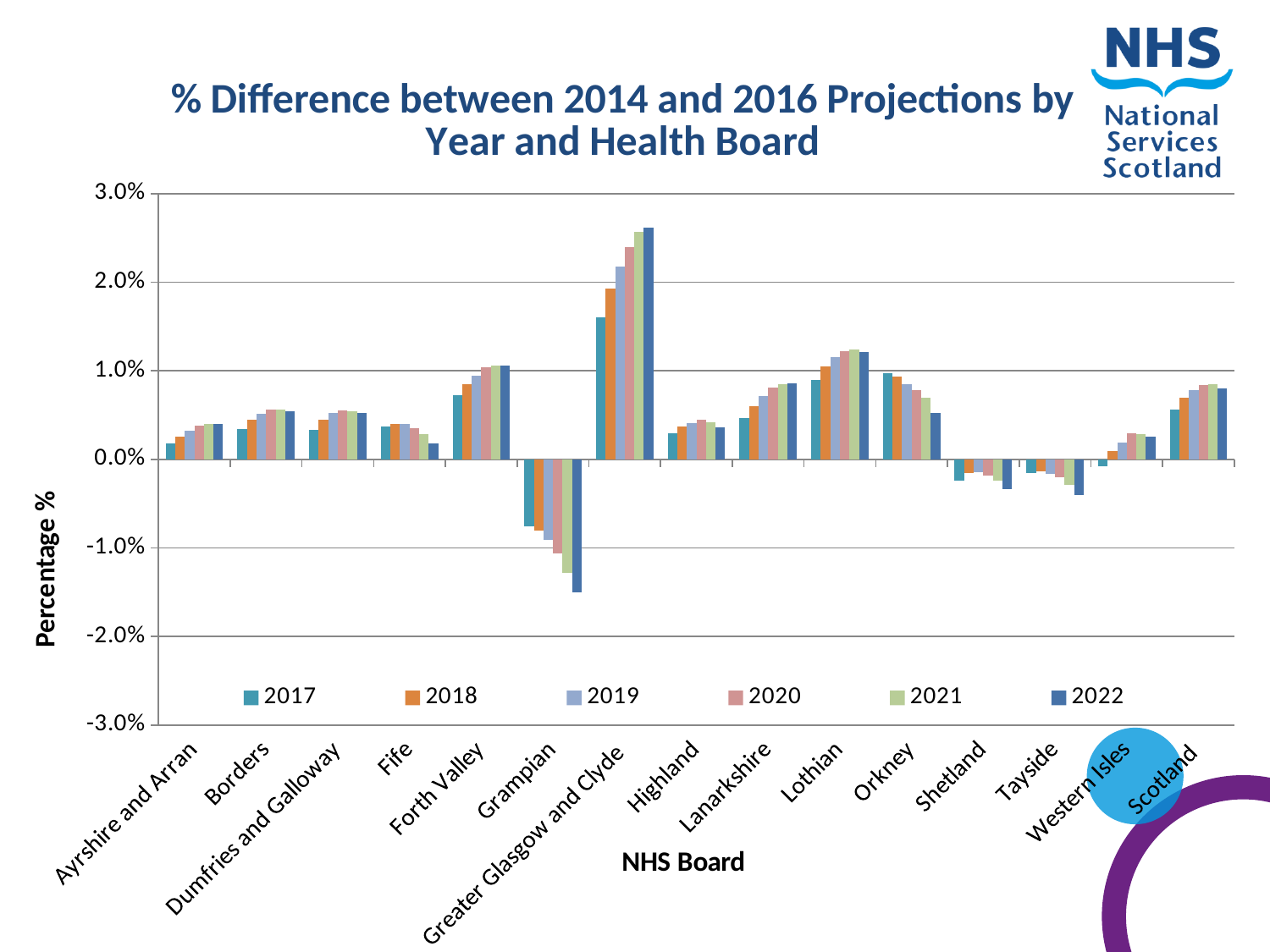
Is the 2021 value for Lothian greater or less than 1.0%? greater Is the 2017 value for Forth Valley greater or less than 1.0%? less Which NHS Board has the highest bar on the chart? Greater Glasgow and Clyde Which NHS Board has the lowest (most negative) bar on the chart? Grampian How many series does the legend list? 6 What kind of chart is shown on the slide? Bar chart Is the 2022 value for Grampian greater or less than -1.0%? less How many NHS Boards (categories) are shown on the x axis? 15 Which is larger for 2017: the value for Lothian or the value for Highland? Lothian What is the title of the chart? % Difference between 2014 and 2016 Projections by Year and Health Board Do the values for Greater Glasgow and Clyde rise or fall from 2017 to 2022? rise